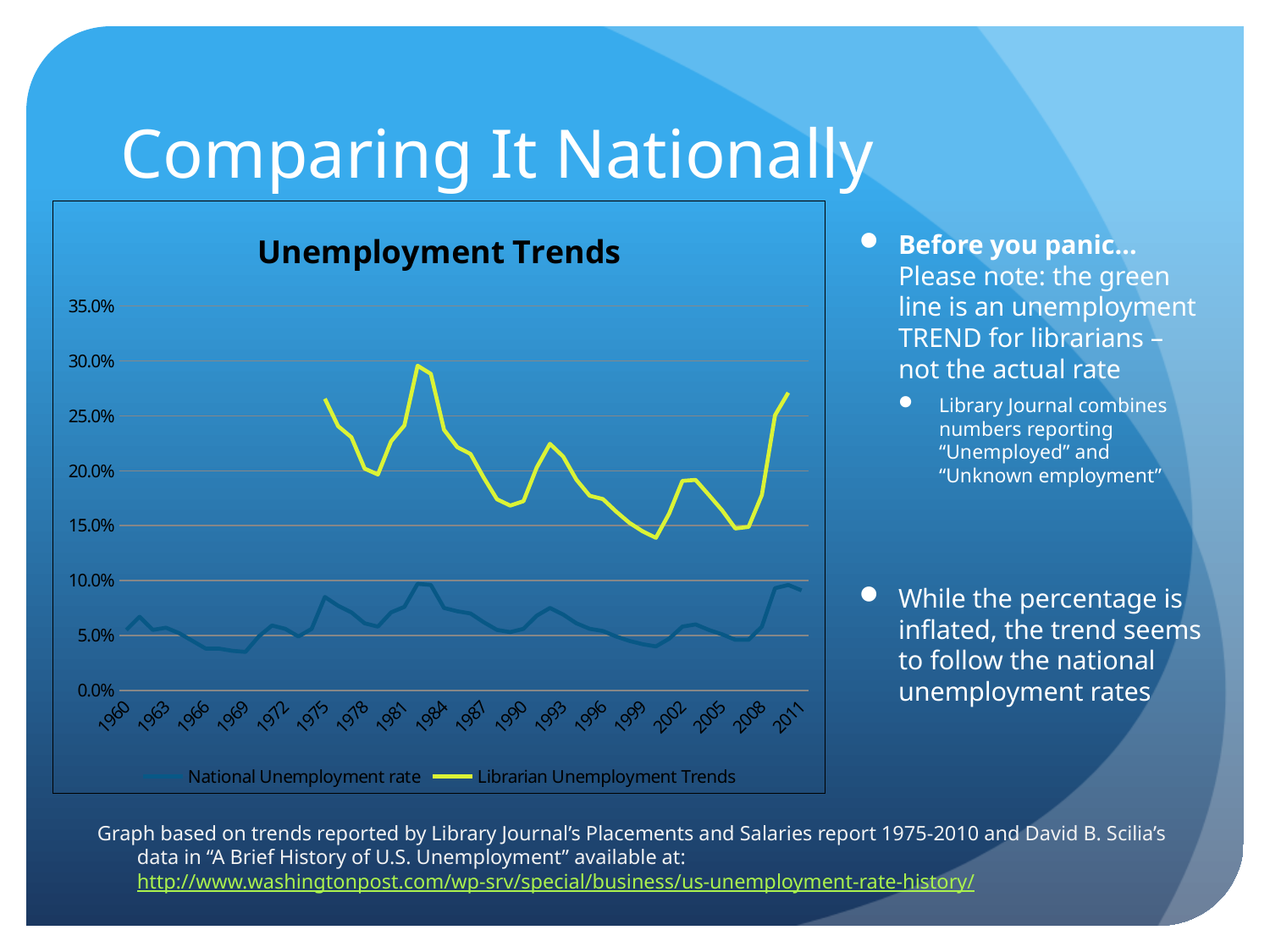
Which series has the higher value in 1984, National Unemployment rate or Librarian Unemployment Trends? Librarian Unemployment Trends Is the National Unemployment rate for 1969 greater or less than 5%? less How many series does the chart's legend list? 2 How many year labels are shown on the x axis of the chart? 18 What is the title of the chart? Unemployment Trends Is the Librarian Unemployment Trends value for 1975 greater or less than 25%? greater Does the Librarian Unemployment Trends line rise or fall between 2005 and 2011? rise Does the Librarian Unemployment Trends line rise or fall between 1993 and 1999? fall Which series is drawn in green on the chart? Librarian Unemployment Trends What type of chart is shown on the slide? line chart Is the National Unemployment rate for 2011 greater or less than 5%? greater